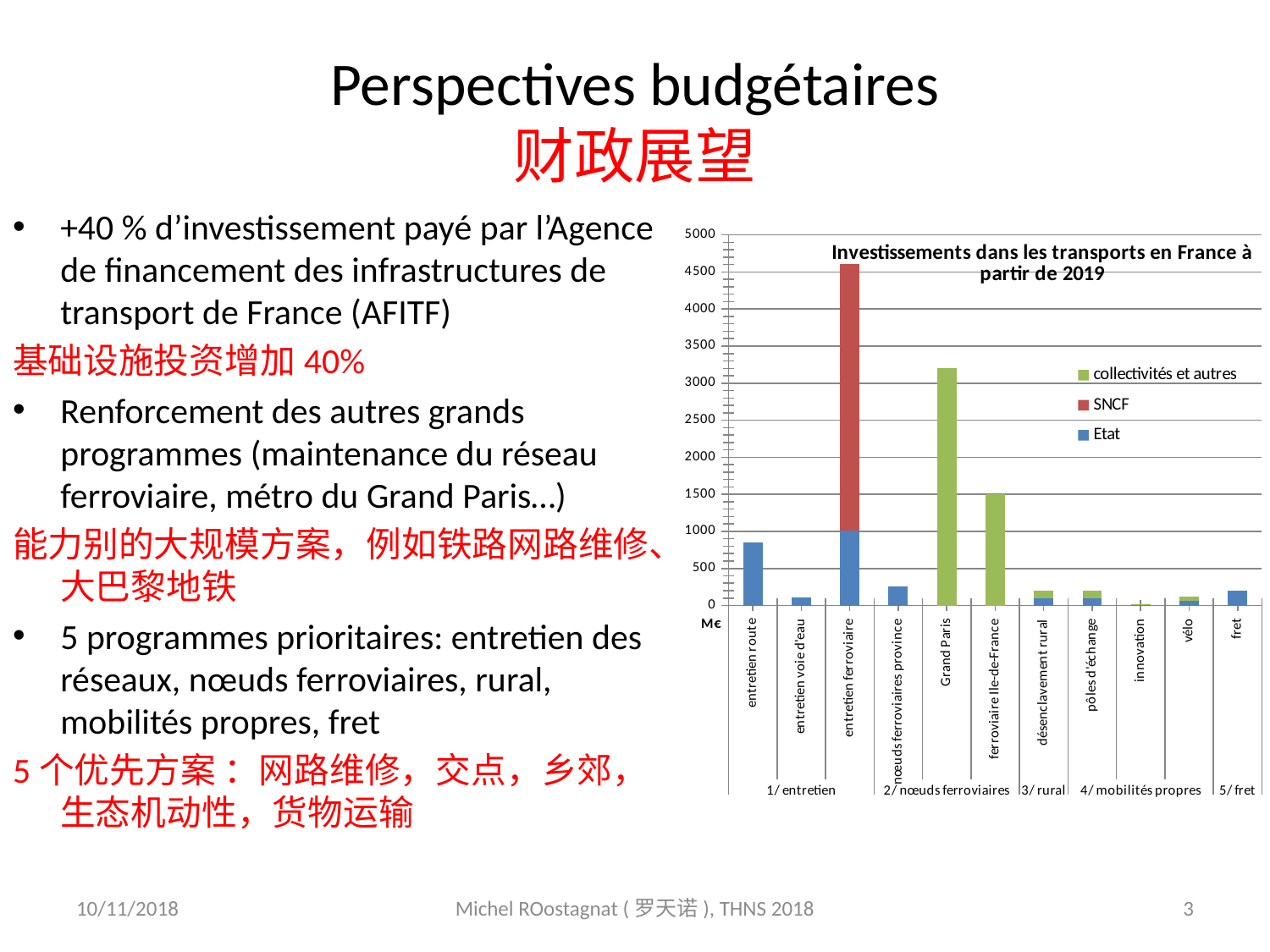
What is the title of the chart? Investissements dans les transports en France à partir de 2019 Is the value for ferroviaire Ile-de-France greater or less than 2000? less Is the value for entretien route greater or less than 500? greater Which category has the smallest bar in the chart? innovation Which is larger, the bar for Grand Paris or the bar for ferroviaire Ile-de-France? Grand Paris Which category has the tallest bar in the chart? entretien ferroviaire Is the total value for entretien ferroviaire greater or less than 4000? greater How many categories are plotted along the x axis of the chart? 11 How many series does the chart legend list? 3 What type of chart is shown on the slide? bar chart Which series in the legend is shown in red? SNCF